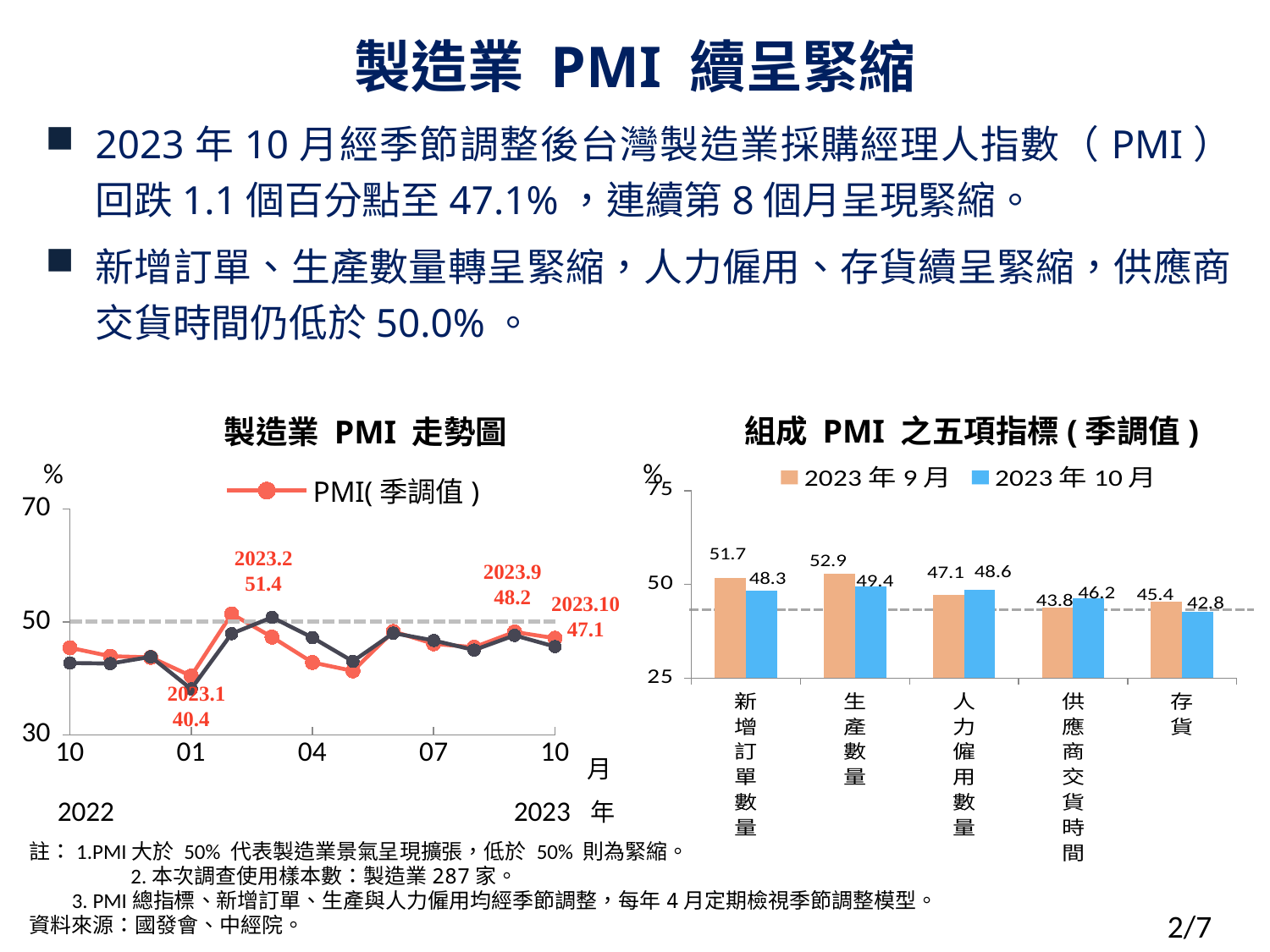
In the chart titled 組成 PMI 之五項指標(季調值), how many categories are shown on the x axis? 5 In the chart titled 組成 PMI 之五項指標(季調值), what is the difference between the 2023年9月 and 2023年10月 values for 新增訂單數量? 3.4 In the chart titled 組成 PMI 之五項指標(季調值), how many series does the legend list? 2 In the chart titled 組成 PMI 之五項指標(季調值), which category has the highest value for 2023年9月? 生產數量 In the chart titled 組成 PMI 之五項指標(季調值), which category has the lowest value for 2023年10月? 存貨 In the chart titled 製造業 PMI 走勢圖, what is the difference between the labeled PMI(季調值) values for 2023.9 and 2023.10? 1.1 In the chart titled 製造業 PMI 走勢圖, is the PMI(季調值) value for 2023.2 greater or less than 50? greater In the chart titled 製造業 PMI 走勢圖, what is the PMI(季調值) value labeled for 2023.1? 40.4 What kind of chart is the one titled 製造業 PMI 走勢圖? line chart In the chart titled 組成 PMI 之五項指標(季調值), what is the value for 新增訂單數量 in 2023年10月? 48.3 In the chart titled 組成 PMI 之五項指標(季調值), which is larger for 供應商交貨時間: the 2023年9月 value or the 2023年10月 value? 2023年10月 In the chart titled 組成 PMI 之五項指標(季調值), what is the value for 生產數量 in 2023年9月? 52.9